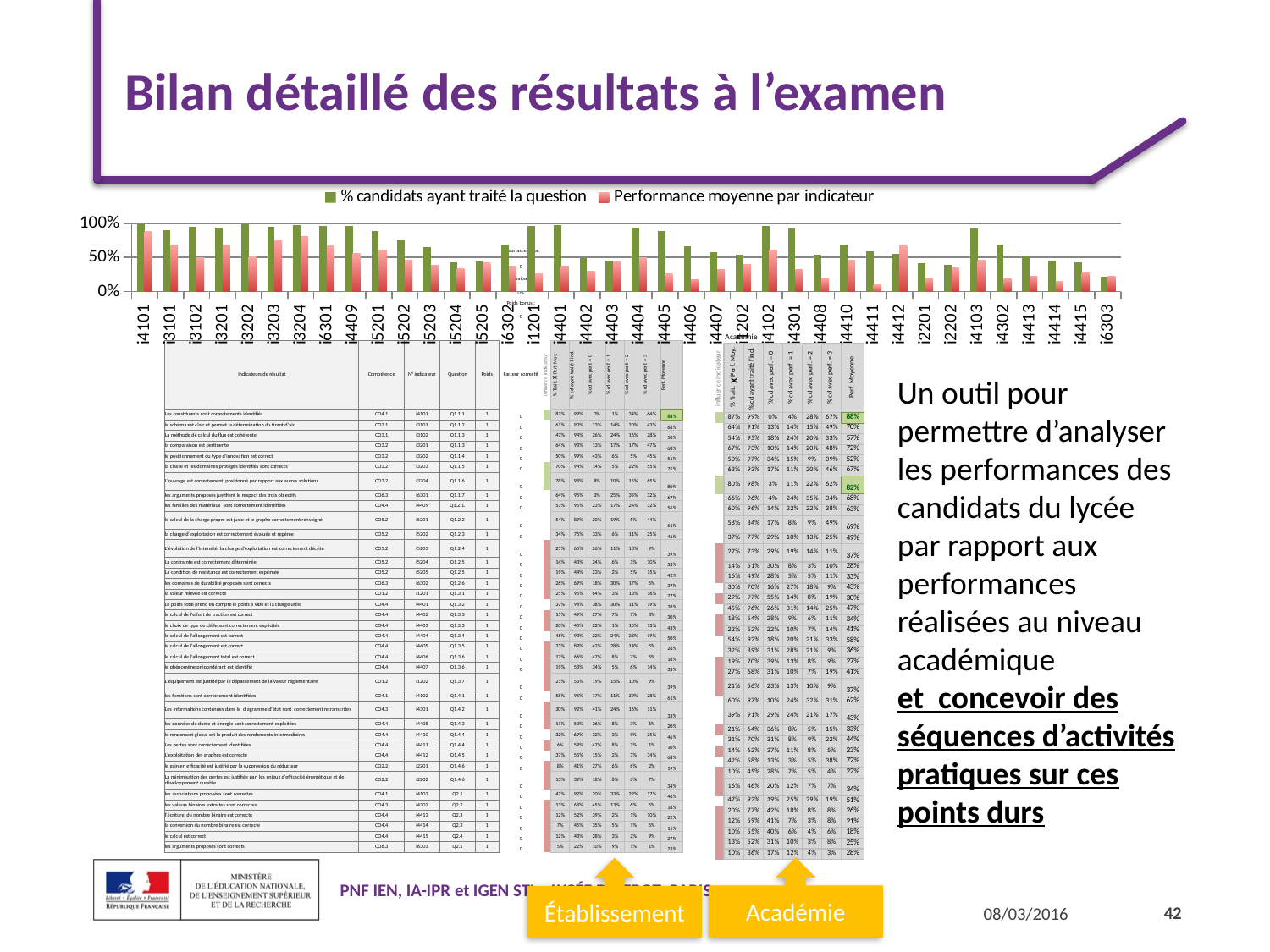
Is the value of '% candidats ayant traité la question' for i4101 greater or less than 50%? greater Is the value of '% candidats ayant traité la question' for i6303 greater or less than 50%? less Which has the larger value of '% candidats ayant traité la question': i4101 or i6303? i4101 Is the value of 'Performance moyenne par indicateur' for i4414 greater or less than 50%? less What are the two series named in the chart legend? % candidats ayant traité la question; Performance moyenne par indicateur What kind of chart is shown on the slide? bar chart For i4401, which series has the larger value: '% candidats ayant traité la question' or 'Performance moyenne par indicateur'? % candidats ayant traité la question Which colour represents the series 'Performance moyenne par indicateur' in the chart? red How many series does the chart legend list? 2